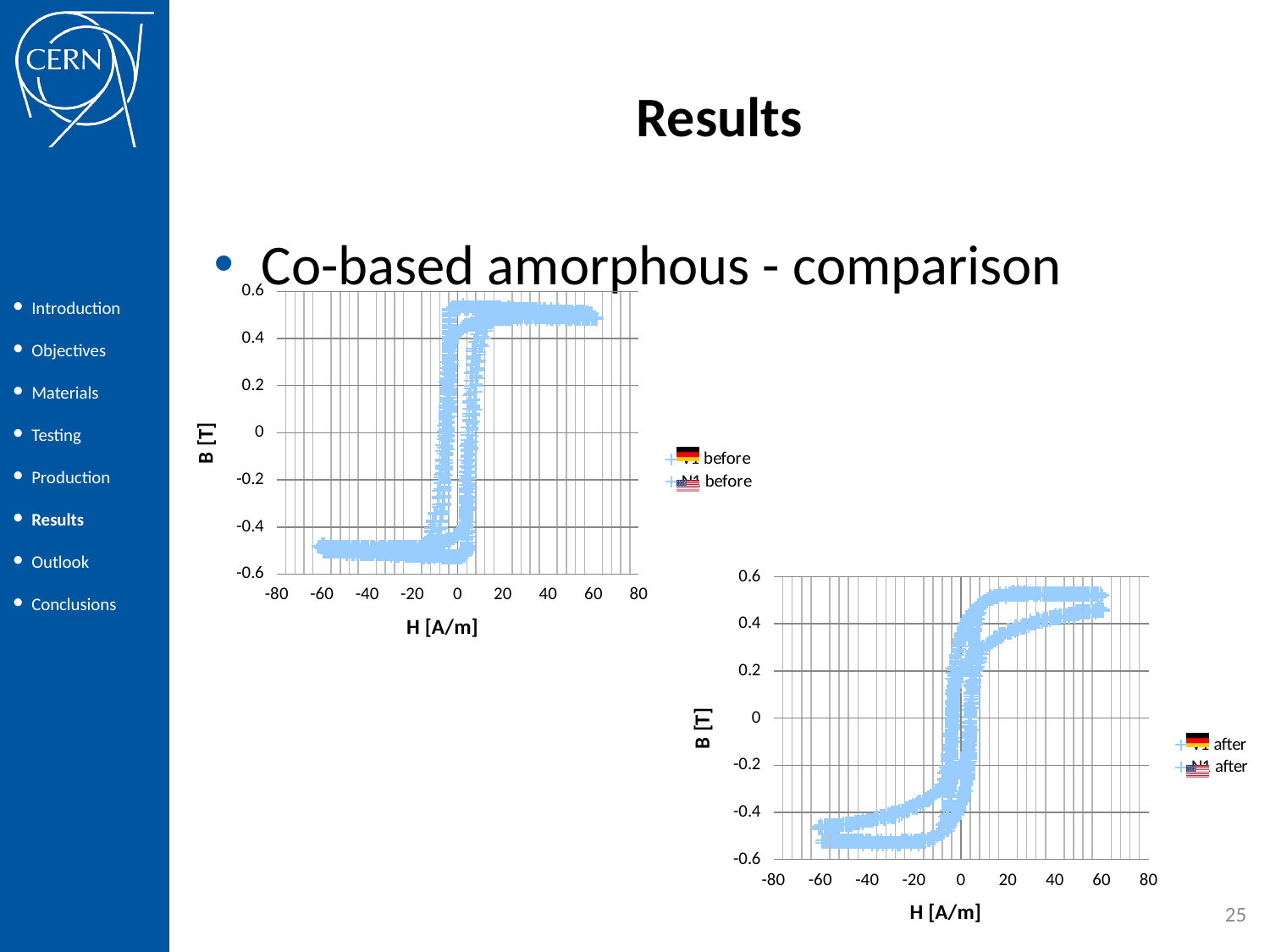
In the right chart, is the lowest B value reached by the data greater or less than -0.6? greater What kind of chart is the right chart on the slide? scatter chart What is the label of the x axis on the right chart? H [A/m] How many series does the legend of the right chart list? 2 What is the label of the y axis on the left chart? B [T] How many series does the legend of the left chart list? 2 In the right chart, is the largest H value reached by the data greater or less than 80? less What kind of chart is the left chart on the slide? scatter chart In the left chart, is the highest B value reached by the data greater or less than 0.4? greater